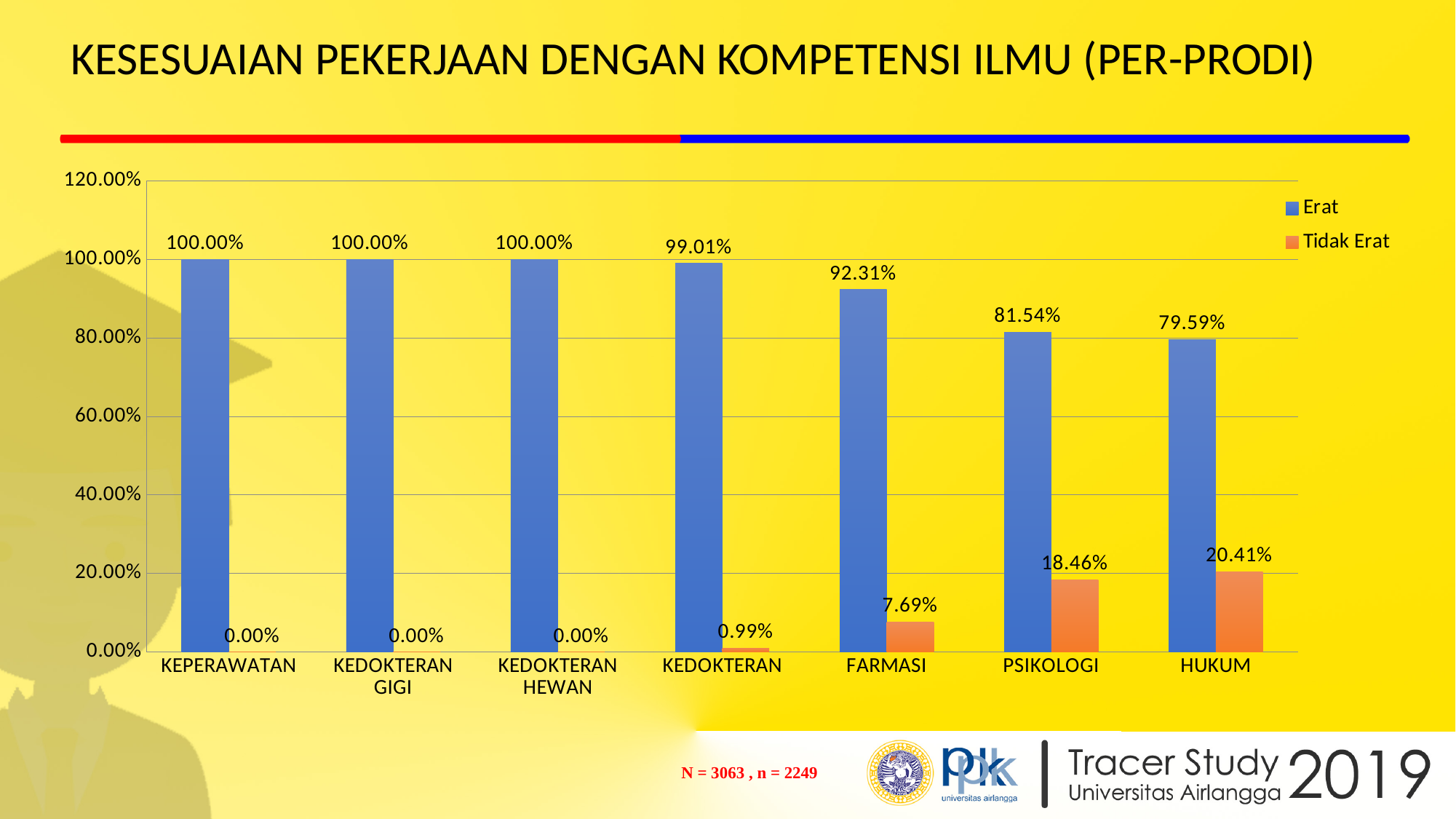
Which category has the lowest Erat value? HUKUM Which category has the highest Tidak Erat value? HUKUM What is the difference between the Erat values for FARMASI and HUKUM? 12.72% How many series does the legend list? 2 What is the Erat value for KEDOKTERAN? 99.01% What is the Erat value for FARMASI? 92.31% What kind of chart is shown on the slide? bar chart Do the Erat values rise or fall from left to right along the x axis? fall Which is larger, the Tidak Erat value for PSIKOLOGI or for FARMASI? PSIKOLOGI How many categories are shown on the x axis? 7 What is the Tidak Erat value for PSIKOLOGI? 18.46% Is the Erat value for PSIKOLOGI greater or less than 80.00%? greater